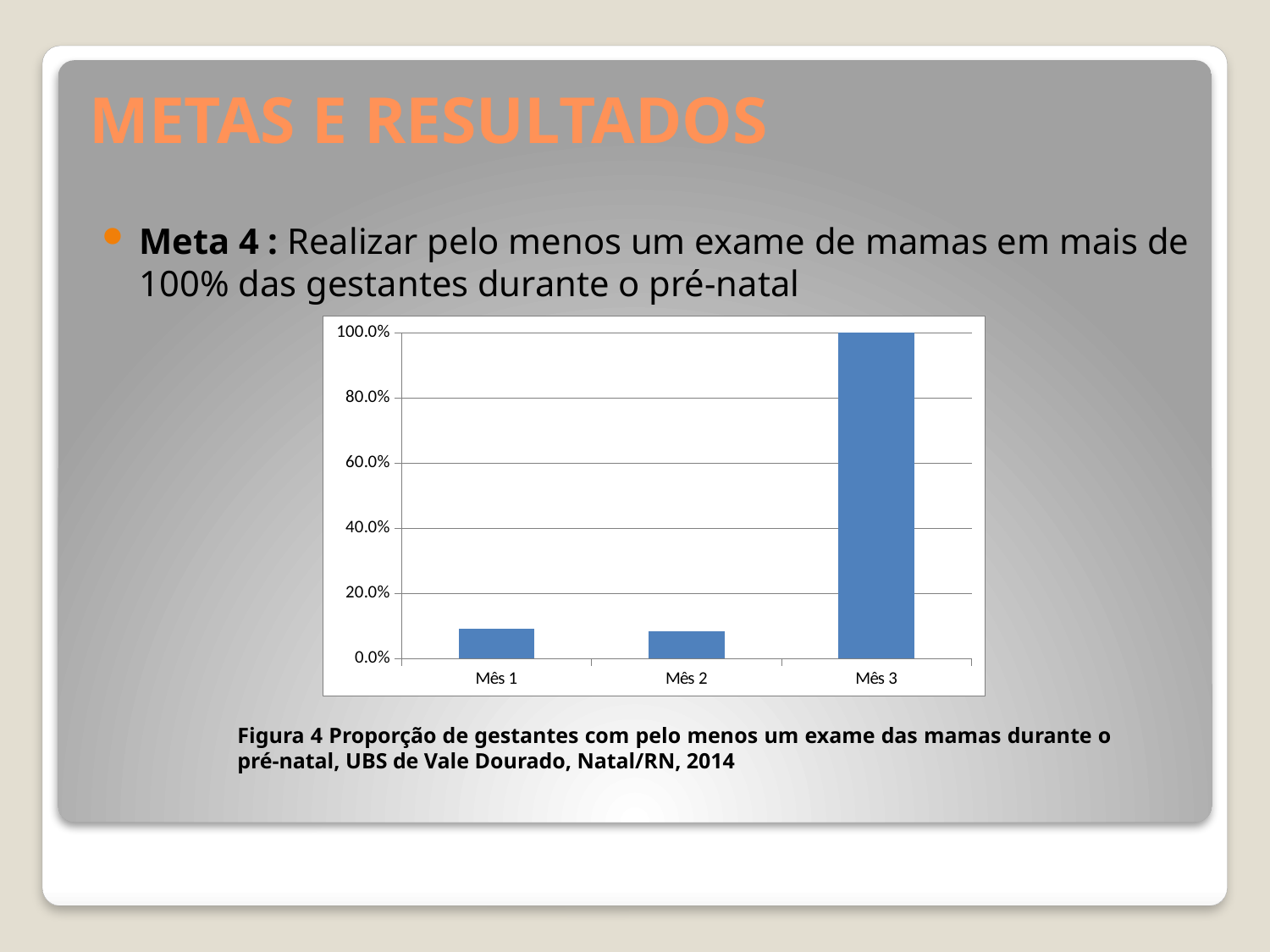
Is the value for Mês 2 greater or less than 20.0%? less What figure number is given in the caption below the chart? Figura 4 What kind of chart is shown on the slide? bar chart Which is larger, the value for Mês 3 or the value for Mês 1? Mês 3 What is the value for Mês 3 in the chart? 100.0% How many categories are shown on the x axis of the chart? 3 What is the highest tick value shown on the y axis of the chart? 100.0% Is the value for Mês 3 greater or less than 80.0%? greater Which month has the highest value in the chart? Mês 3 Which is larger, the value for Mês 2 or the value for Mês 3? Mês 3 Is the value for Mês 1 greater or less than 20.0%? less